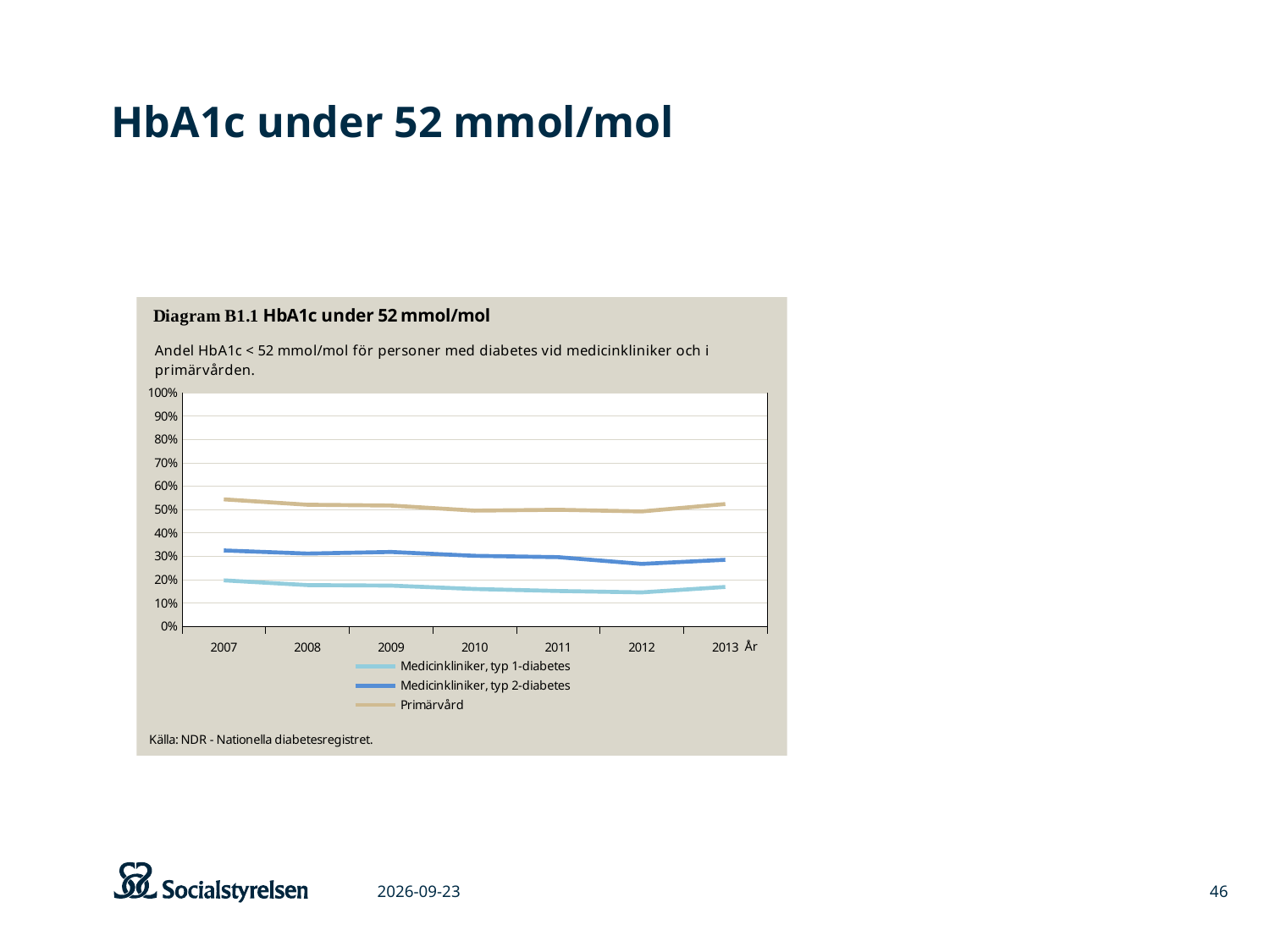
What source is cited below the chart? NDR - Nationella diabetesregistret Is the value for Primärvård in 2007 greater or less than 50%? greater Is the value for Medicinkliniker, typ 2-diabetes in 2009 greater or less than 40%? less Which series has the highest values throughout the chart? Primärvård In 2013, which is larger: the value for Medicinkliniker, typ 2-diabetes or for Medicinkliniker, typ 1-diabetes? Medicinkliniker, typ 2-diabetes How many series does the legend list? 3 What is the first year shown on the x axis? 2007 Is the value for Medicinkliniker, typ 1-diabetes in 2012 greater or less than 20%? less Does the Medicinkliniker, typ 2-diabetes series generally rise or fall from 2007 to 2012? fall Which series has the lowest values throughout the chart? Medicinkliniker, typ 1-diabetes How many years are plotted along the x axis? 7 What kind of chart is shown on the slide? line chart